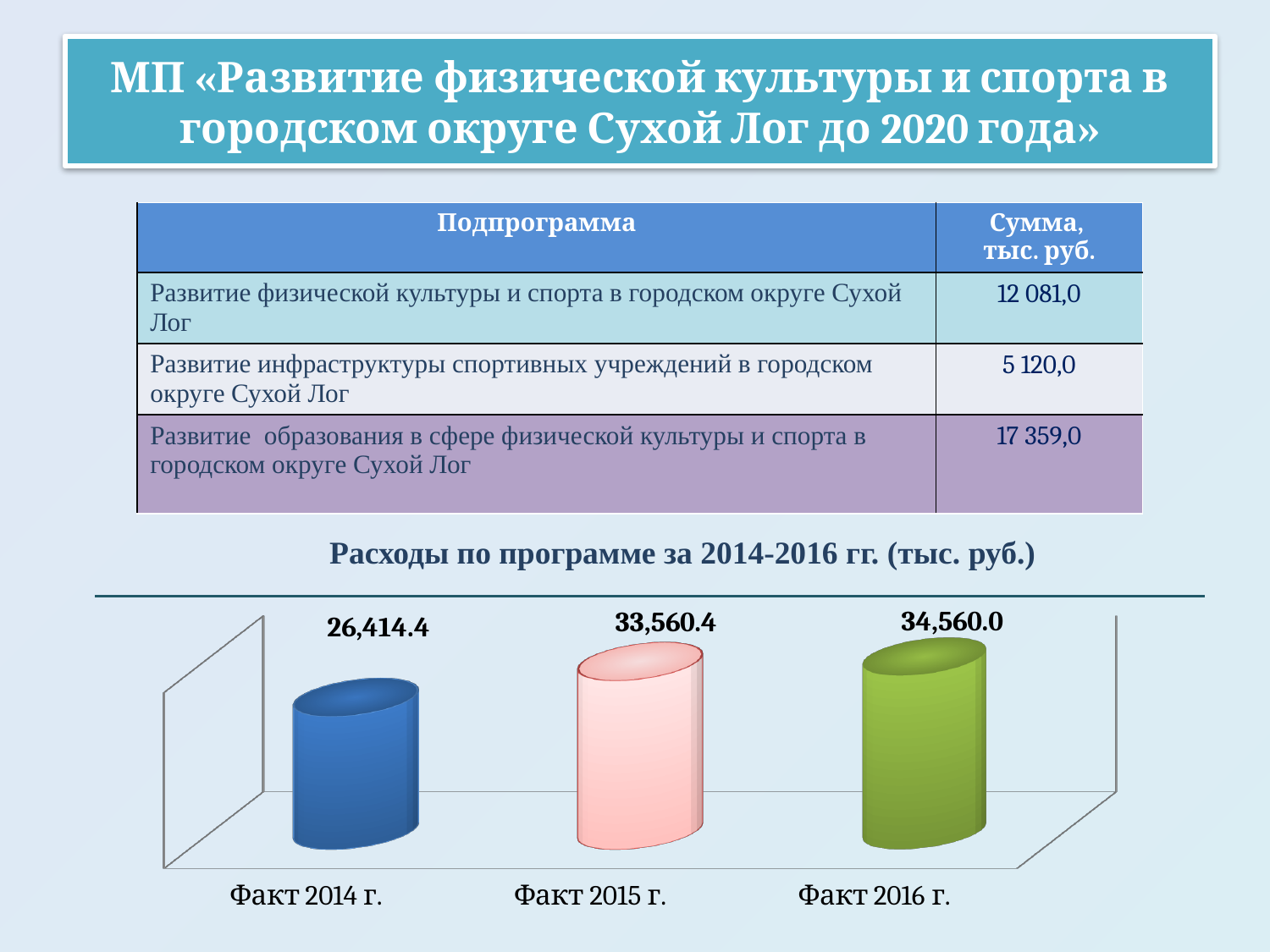
What is the value for Факт 2016 г. in the chart? 34,560.0 What is the title of the chart? Расходы по программе за 2014-2016 гг. (тыс. руб.) How many categories are shown in the chart? 3 What is the value for Факт 2014 г. in the chart? 26,414.4 Which category has the highest value in the chart? Факт 2016 г. Do the values in the chart rise or fall from 2014 to 2016? Rise What is the difference between the values for Факт 2015 г. and Факт 2014 г.? 7,146.0 Which category has the lowest value in the chart? Факт 2014 г. What is the difference between the values for Факт 2016 г. and Факт 2015 г.? 999.6 What is the value for Факт 2015 г. in the chart? 33,560.4 What kind of chart is shown on the slide? Bar chart Which is larger, the value for Факт 2014 г. or the value for Факт 2015 г.? Факт 2015 г.